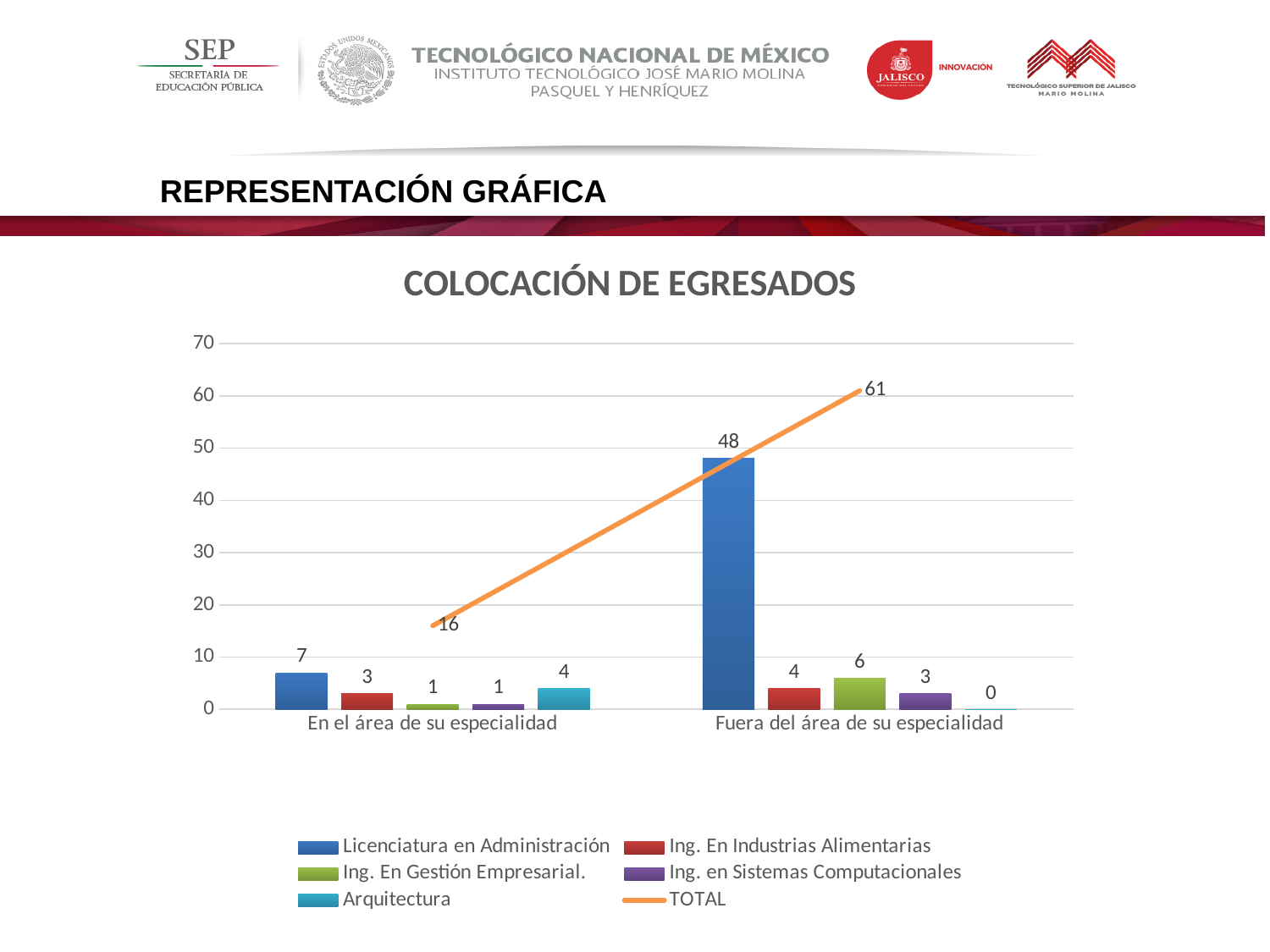
What is the difference between the TOTAL values for "Fuera del área de su especialidad" and "En el área de su especialidad"? 45 What is the title of the chart? COLOCACIÓN DE EGRESADOS How many categories are shown on the x axis? 2 Which series has the highest value in the category "Fuera del área de su especialidad"? TOTAL How many series does the legend list? 6 Does the TOTAL line rise or fall from "En el área de su especialidad" to "Fuera del área de su especialidad"? rise What is the value for Licenciatura en Administración in the category "Fuera del área de su especialidad"? 48 What is the value for Arquitectura in the category "Fuera del área de su especialidad"? 0 What is the TOTAL value for "En el área de su especialidad"? 16 What is the value for Licenciatura en Administración in the category "En el área de su especialidad"? 7 Which is larger: Ing. En Gestión Empresarial. in "Fuera del área de su especialidad" or Arquitectura in "En el área de su especialidad"? Ing. En Gestión Empresarial. in "Fuera del área de su especialidad" What is the TOTAL value for "Fuera del área de su especialidad"? 61